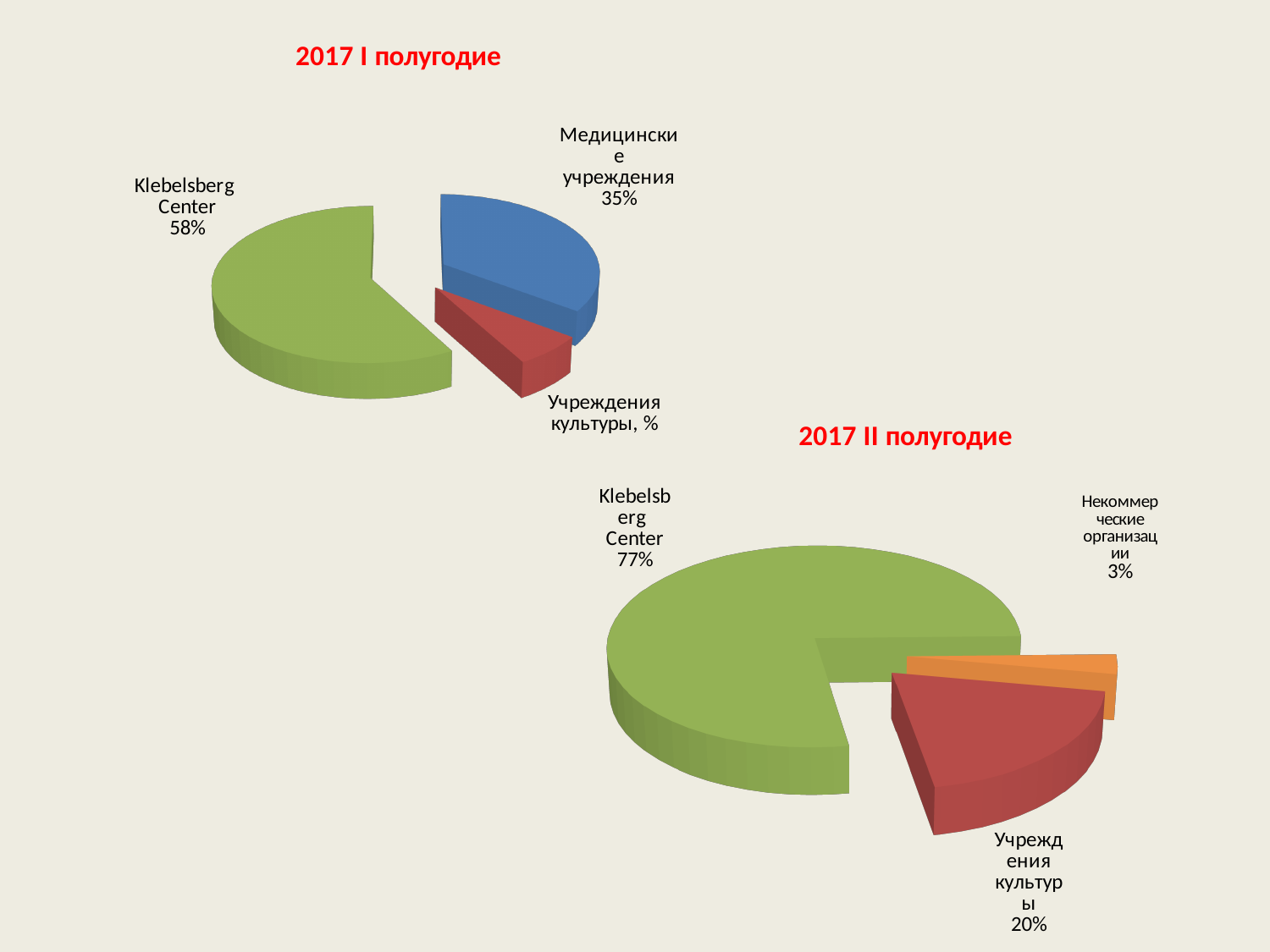
In the 2017 I полугодие chart, what share do Медицинские учреждения have? 35% In the 2017 II полугодие chart, how many percentage points larger is Учреждения культуры than Некоммерческие организации? 17 percentage points In the 2017 I полугодие chart, what share does Klebelsberg Center have? 58% In the 2017 II полугодие chart, which category has the smallest slice? Некоммерческие организации What type of chart is used for 2017 I полугодие? Pie chart In the 2017 II полугодие chart, what share do Некоммерческие организации have? 3% In the 2017 I полугодие chart, how many percentage points larger is Klebelsberg Center than Медицинские учреждения? 23 percentage points In the 2017 I полугодие chart, which category has the largest slice? Klebelsberg Center How many slices does the 2017 II полугодие chart have? 3 In the 2017 II полугодие chart, what share do Учреждения культуры have? 20% In the 2017 I полугодие chart, which category has the smallest slice? Учреждения культуры In the 2017 II полугодие chart, what share does Klebelsberg Center have? 77%